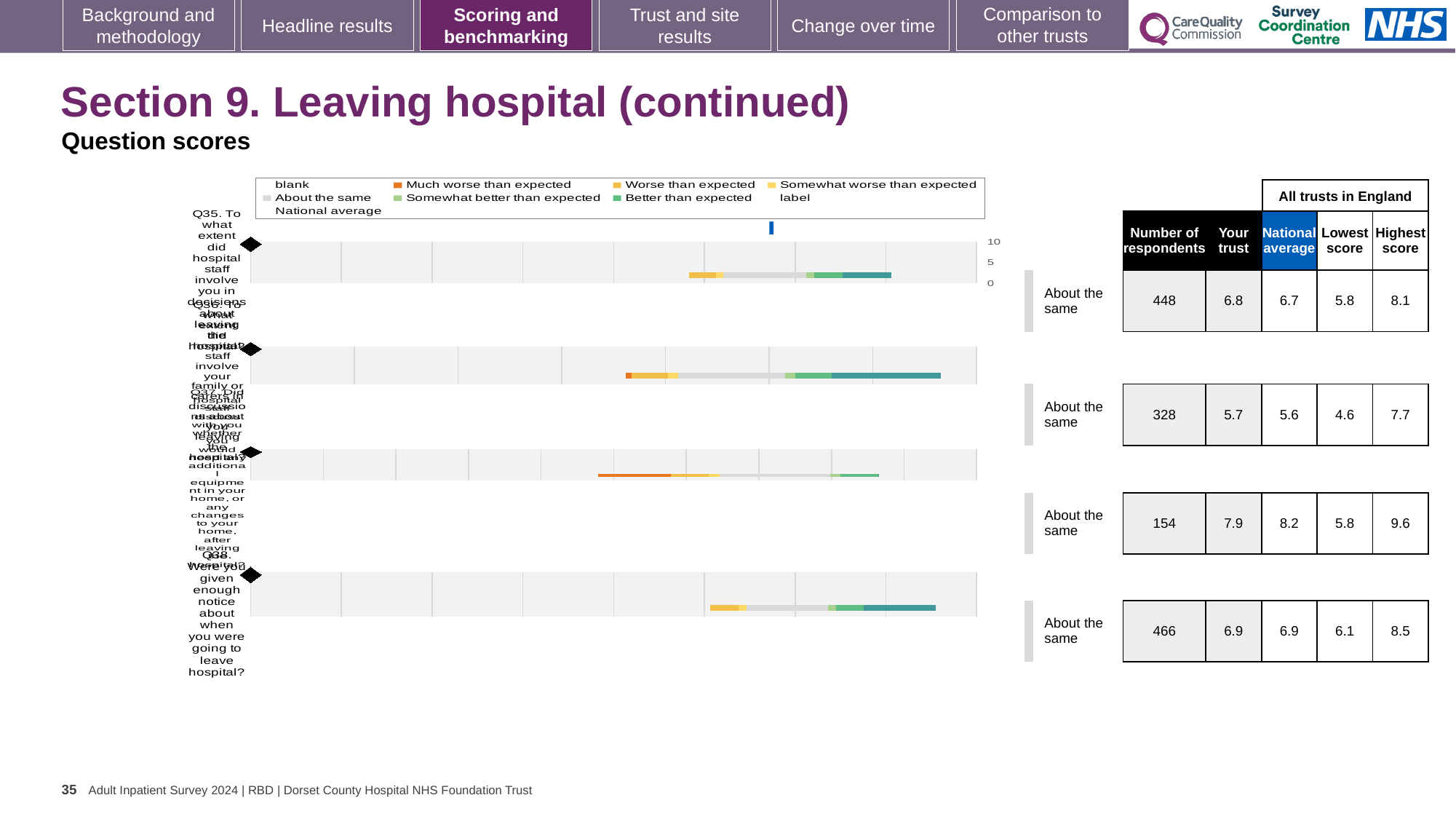
In the table beside the chart, which row has the lowest number of respondents? the third row (Q37), 154 In the table beside the chart, which row has the highest 'Your trust' score? the third row (Q37), 7.9 In the table beside the chart, what is the number of respondents for the last row (Q38)? 466 In the chart legend, which colour represents 'Much worse than expected'? orange In the table beside the chart, for the second row (Q36), is the 'Your trust' score or the 'National average' larger? Your trust (5.7) What kind of chart is shown on the slide? bar chart In the chart legend, which colour represents 'Better than expected'? teal In the table beside the chart, what is the difference between the highest score and the lowest score for the first row (Q35)? 2.3 How many entries does the chart legend list? 9 In the table beside the chart, what is the 'Your trust' score for the first row (Q35)? 6.8 What benchmark category is shown beside every bar in the chart? About the same How many question bars are plotted in the chart? 4